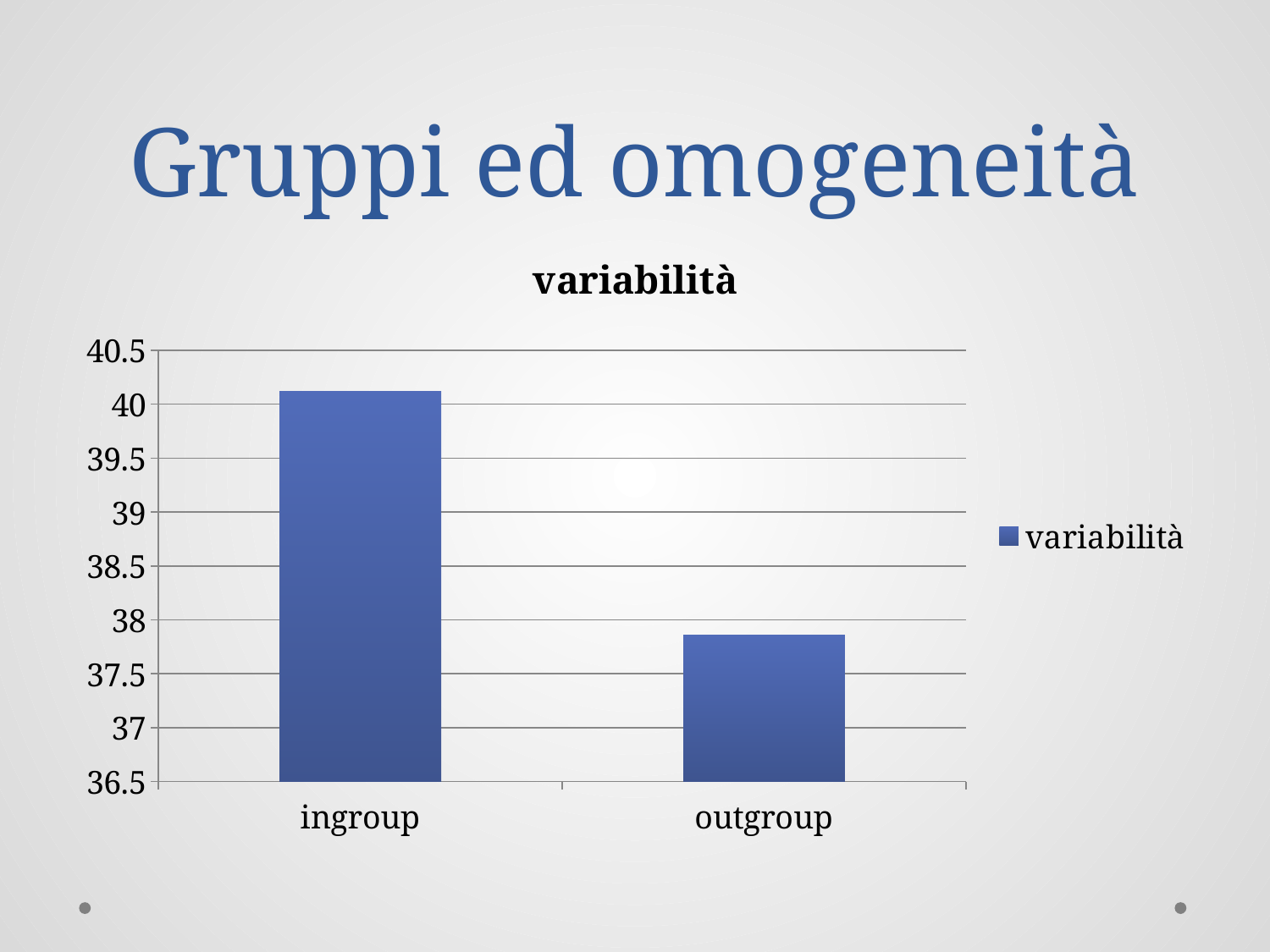
Which category has the lowest value? outgroup Is the value for outgroup greater or less than 38? less Is the value for outgroup greater or less than 37.5? greater What kind of chart is shown on the slide? bar chart Is the value for ingroup greater or less than 40? greater What is the title of the chart? variabilità Do the values rise or fall from ingroup to outgroup along the x axis? fall What is the name of the series shown in the legend? variabilità How many series does the legend list? 1 Which category has the highest value? ingroup Which is larger, the value for ingroup or the value for outgroup? ingroup How many categories are shown on the x axis of the chart? 2